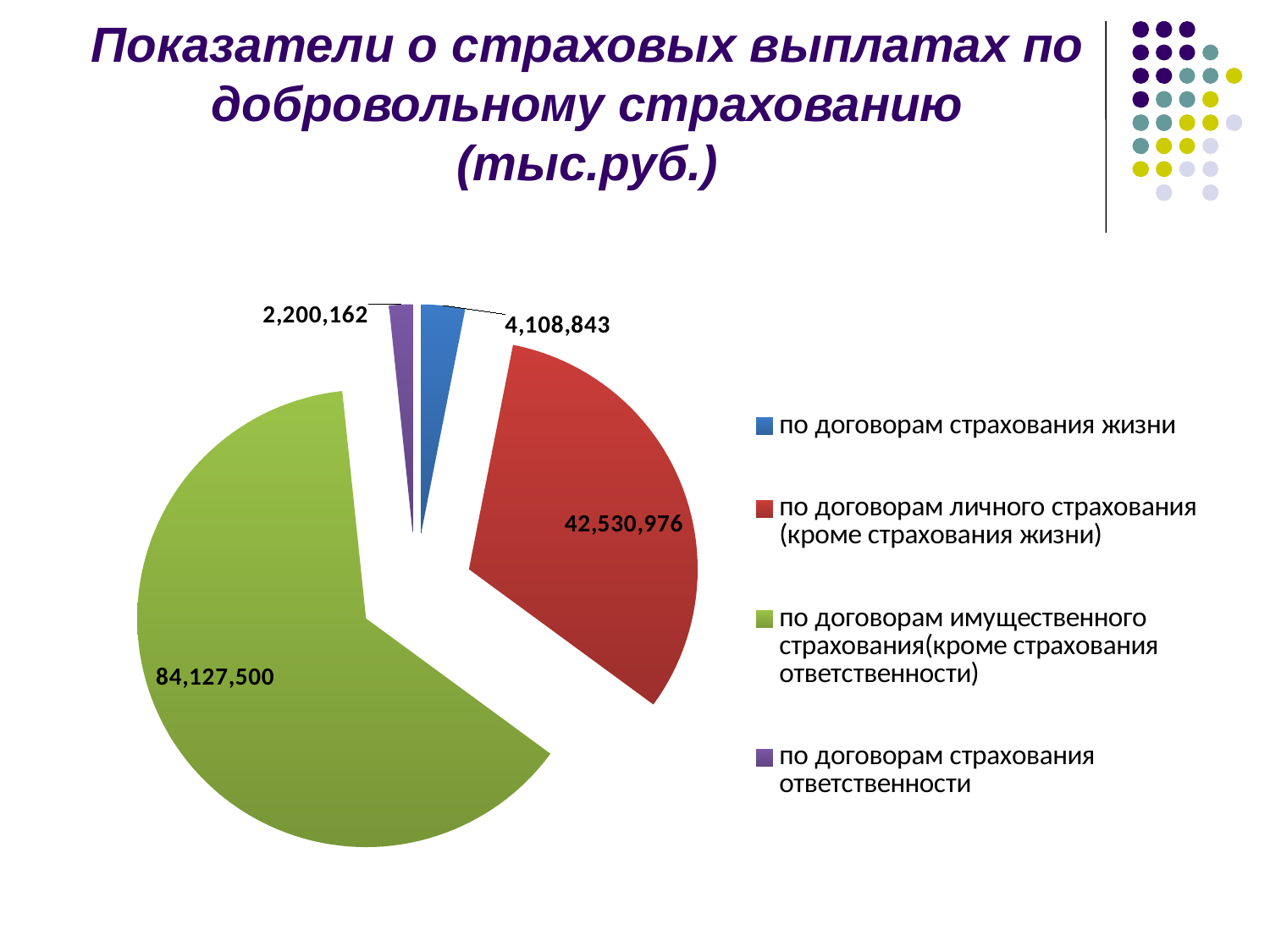
Which category has the smallest slice of the pie? по договорам страхования ответственности What is the value for 'по договорам имущественного страхования(кроме страхования ответственности)'? 84,127,500 What type of chart is shown on the slide? pie chart What is the value for 'по договорам страхования жизни'? 4,108,843 What is the difference between the values for life insurance (страхования жизни) and liability insurance (страхования ответственности)? 1,908,681 How many categories does the pie chart show? 4 Which category has the largest slice of the pie? по договорам имущественного страхования(кроме страхования ответственности) What is the value for 'по договорам личного страхования (кроме страхования жизни)'? 42,530,976 What colour is the slice for 'по договорам личного страхования (кроме страхования жизни)'? red Which is larger: the value for 'по договорам страхования жизни' or 'по договорам страхования ответственности'? по договорам страхования жизни What is the difference between the values for property insurance (имущественного страхования) and personal insurance (личного страхования)? 41,596,524 What is the value for 'по договорам страхования ответственности'? 2,200,162